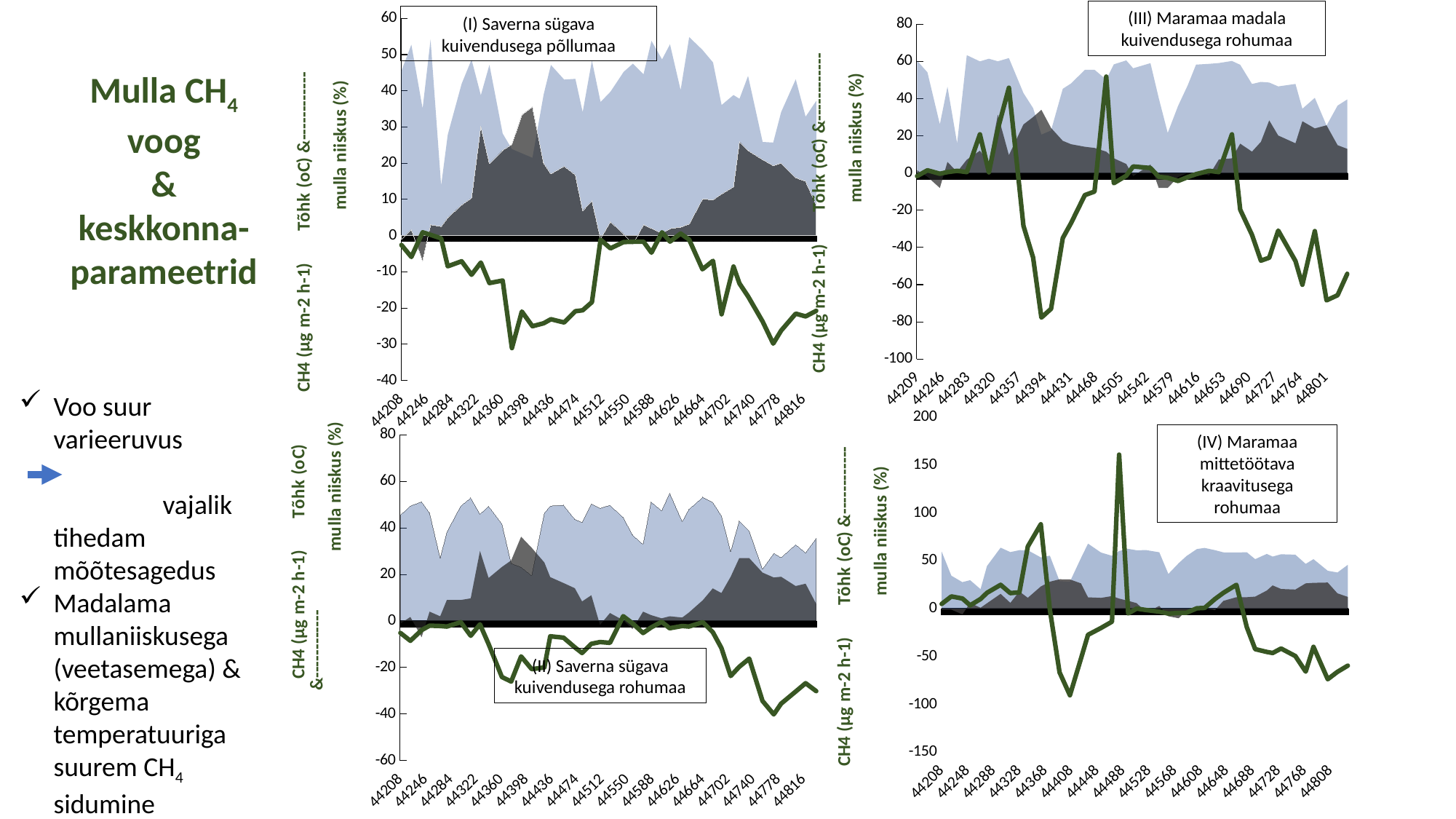
In the chart titled '(IV) Maramaa mittetöötava kraavitusega rohumaa', what is the highest value shown on the y axis? 200 In the chart titled '(III) Maramaa madala kuivendusega rohumaa', what is the lowest value shown on the y axis? -100 In the chart titled '(IV) Maramaa mittetöötava kraavitusega rohumaa', is the peak of the CH4 line greater or less than 100? greater What kind of chart is the top-right chart '(III) Maramaa madala kuivendusega rohumaa'? area and line chart In the chart titled '(II) Saverna sügava kuivendusega rohumaa', is the CH4 line value at 44778 greater or less than -20? less How many charts are shown on the slide? 4 What is the title of the top-left chart? (I) Saverna sügava kuivendusega põllumaa In the chart titled '(I) Saverna sügava kuivendusega põllumaa', is the CH4 line value at 44398 greater or less than -20? less In the chart titled '(I) Saverna sügava kuivendusega põllumaa', does the CH4 line rise or fall between 44702 and 44778? fall In the chart titled '(I) Saverna sügava kuivendusega põllumaa', which has the larger CH4 line value: 44398 or 44550? 44550 In the chart titled '(III) Maramaa madala kuivendusega rohumaa', does the CH4 line rise or fall overall between 44690 and 44801? fall